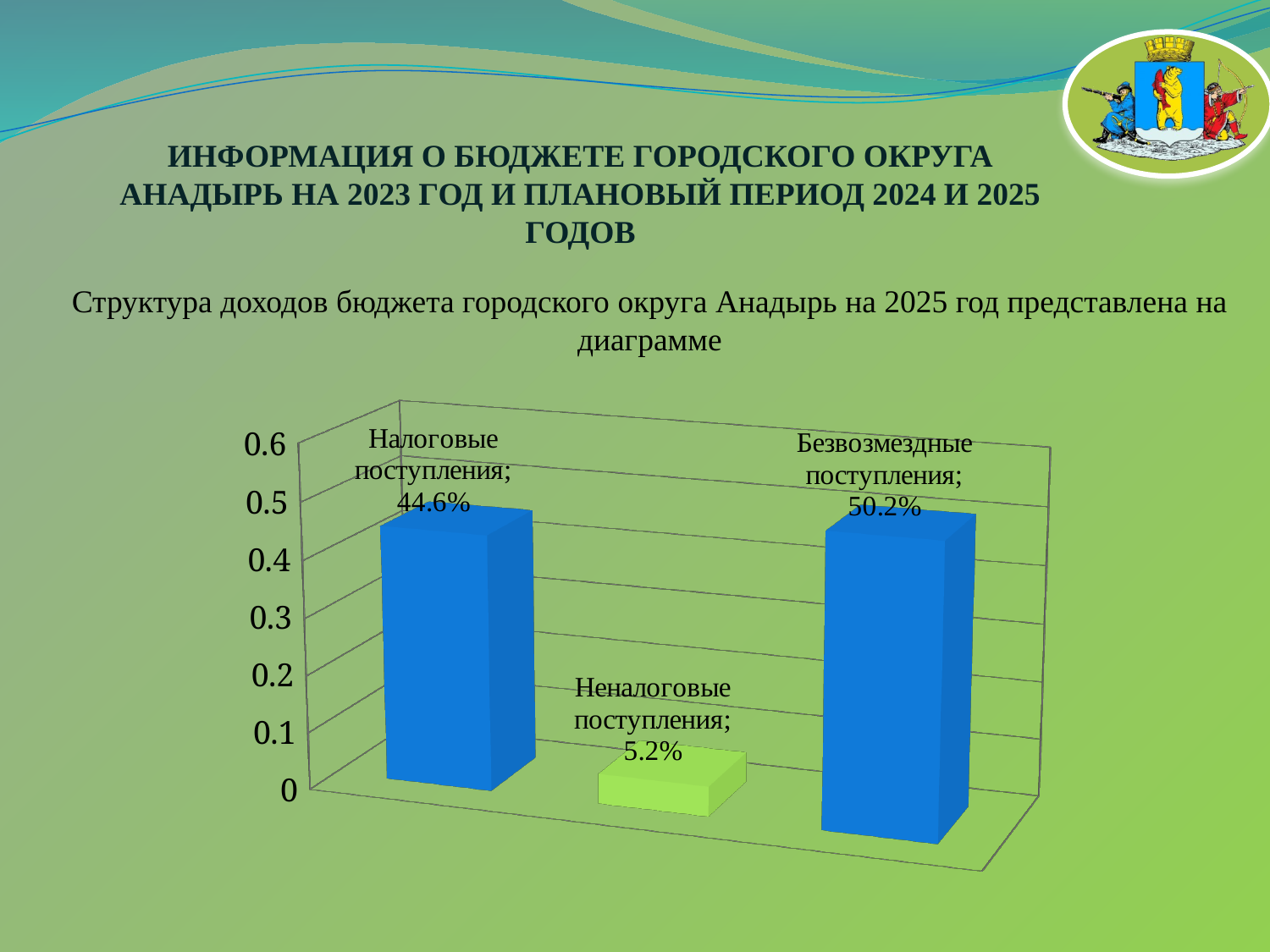
Which category has the lowest value? Неналоговые поступления What is the value for Неналоговые поступления? 5.2% What is the highest tick value shown on the vertical axis? 0.6 What is the value for Безвозмездные поступления? 50.2% What is the difference between Безвозмездные поступления and Налоговые поступления? 5.6% What kind of chart is shown on the slide? bar chart What is the difference between Налоговые поступления and Неналоговые поступления? 39.4% Which category has the highest value? Безвозмездные поступления How many categories are shown in the chart? 3 What is the value for Налоговые поступления? 44.6% Which is larger, Налоговые поступления or Безвозмездные поступления? Безвозмездные поступления Is the value for Налоговые поступления greater or less than 0.5? less